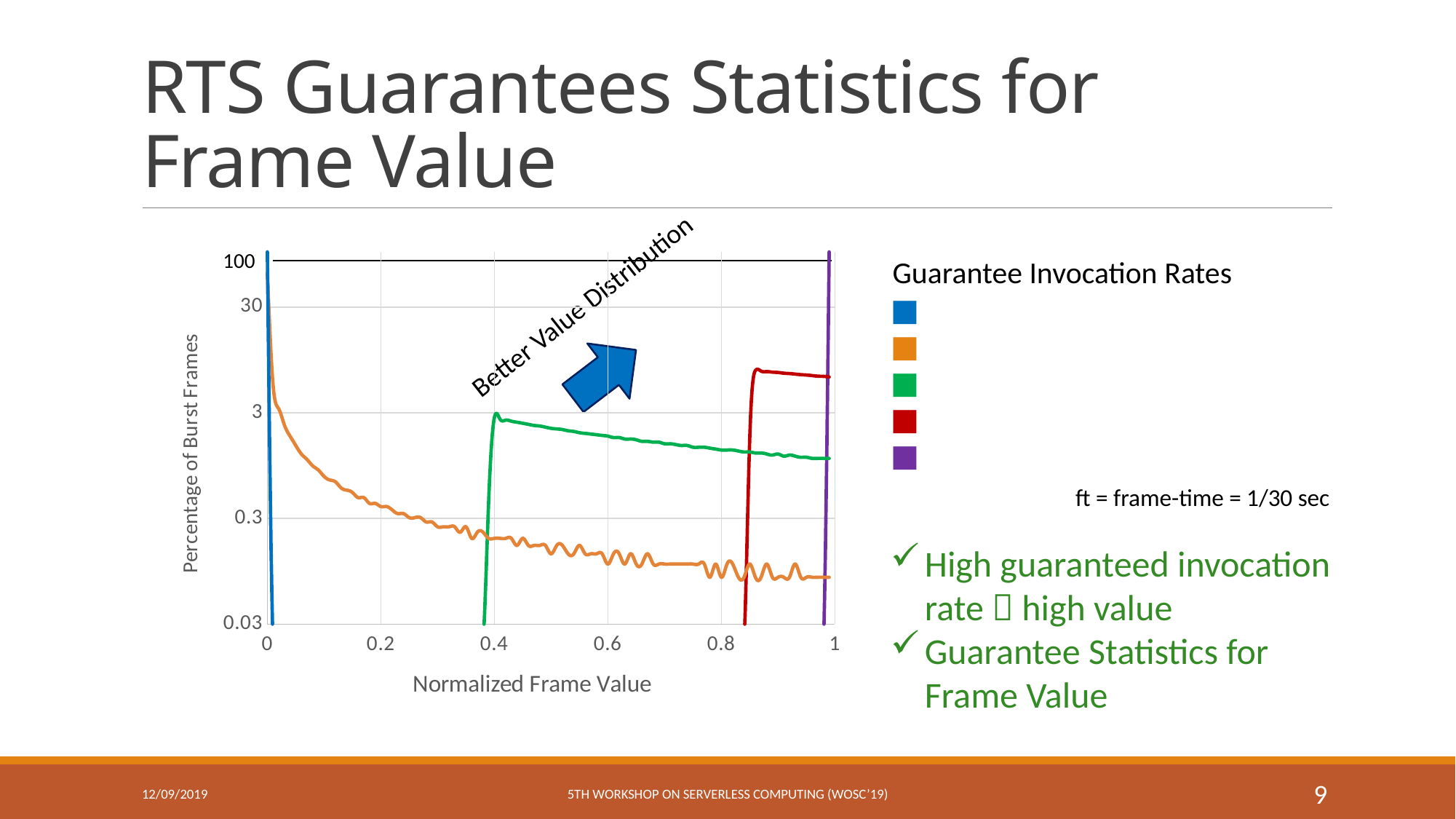
Is the value of the red line at a normalized frame value of 0.9 greater or less than 3? greater Does the orange line rise or fall as the normalized frame value increases? fall Is the value of the green line at a normalized frame value of 0.6 greater or less than 3? less What is the label of the x axis? Normalized Frame Value At a normalized frame value of 0.9, which line is higher, the red line or the green line? red line Is the value of the green line at a normalized frame value of 0.5 greater or less than 0.3? greater Does the green line rise or fall between normalized frame values of 0.4 and 1? fall What is the title of the legend? Guarantee Invocation Rates What kind of chart is shown on the slide? line chart At a normalized frame value of 0.6, which line is higher, the green line or the orange line? green line How many series does the legend list? 5